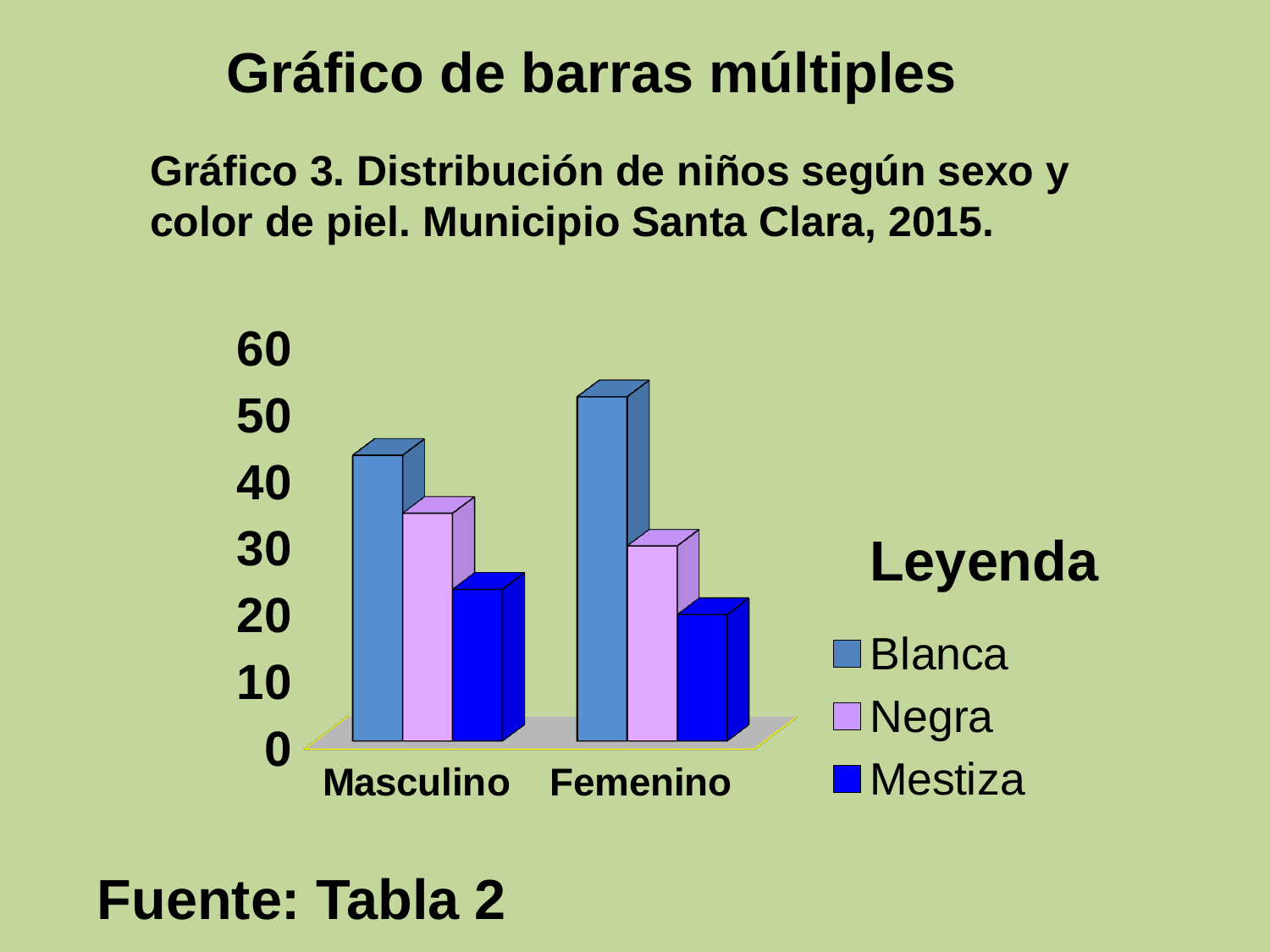
Which bar is the tallest in the whole chart? Blanca for Femenino Which series has the tallest bar in the Femenino group? Blanca Which series has the shortest bar in the Masculino group? Mestiza How many series does the legend list? 3 Which is larger, the Negra value for Masculino or the Negra value for Femenino? Masculino Is the Blanca value for Masculino greater or less than 40? greater What kind of chart is shown on the slide? bar chart What is the title of the legend on the chart? Leyenda Which is larger, the Blanca value for Masculino or the Blanca value for Femenino? Femenino How many categories are shown on the x axis? 2 Is the Mestiza value for Masculino greater or less than 30? less Is the Blanca value for Femenino greater or less than 50? greater